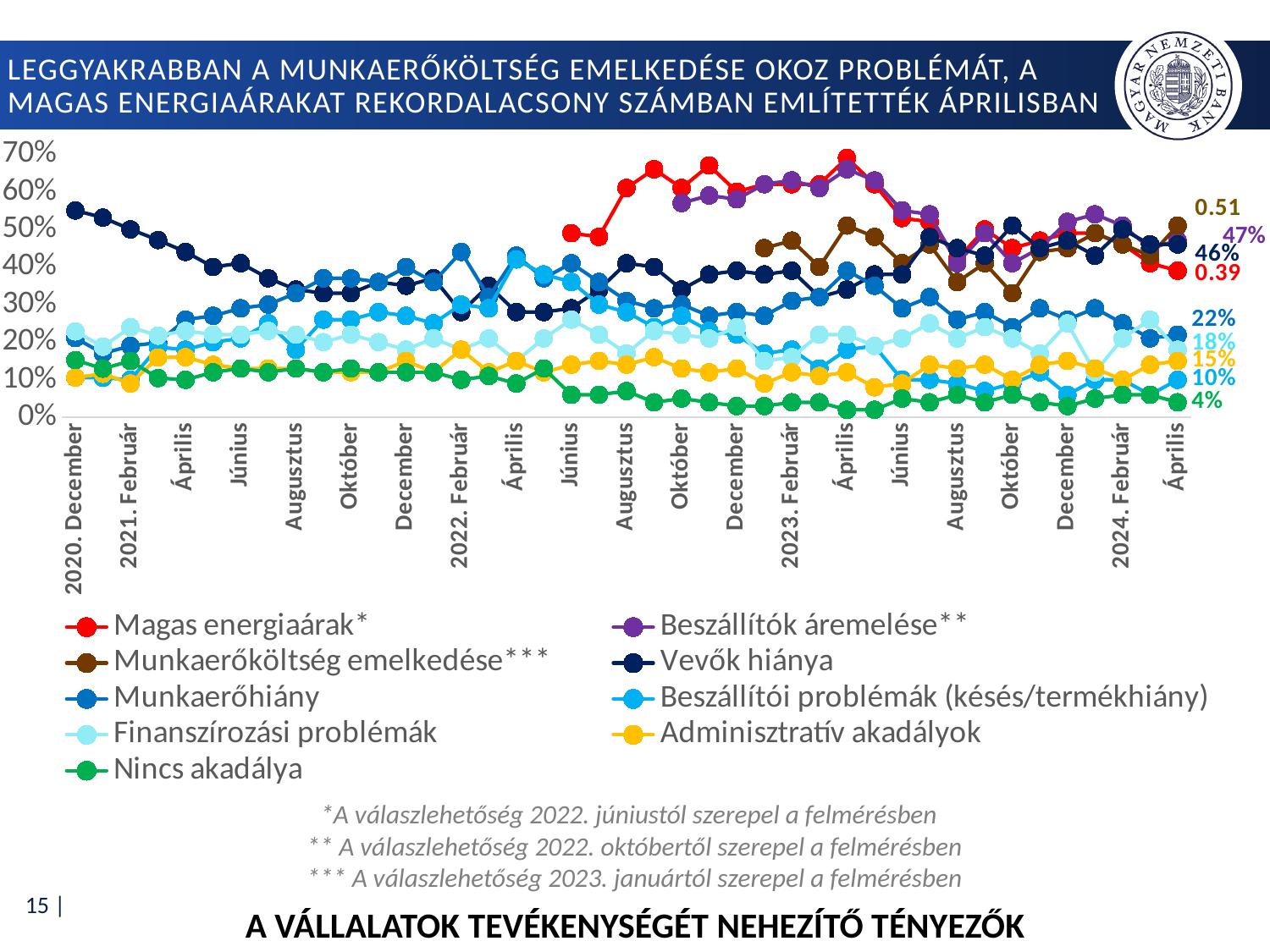
Is the value for Vevők hiánya in 2020 December greater or less than 50%? greater Which series has the highest value at the end of the chart (2024 April)? Munkaerőköltség emelkedése What is the difference between the latest values of Munkaerőhiány (22%) and Beszállítói problémák (10%)? 12 percentage points What is the latest value labelled for Magas energiaárak? 0.39 What type of chart is shown on the slide? line chart Does the Vevők hiánya series rise or fall between 2020 December and 2021 August? fall What is the latest value labelled for Beszállítók áremelése? 47% Which series has the lowest value at the end of the chart (2024 April)? Nincs akadálya How many series does the legend list? 9 What is the latest value labelled for Nincs akadálya? 4% What is the latest value labelled for Vevők hiánya? 46% What is the latest (2024 April) value labelled for Munkaerőköltség emelkedése? 0.51